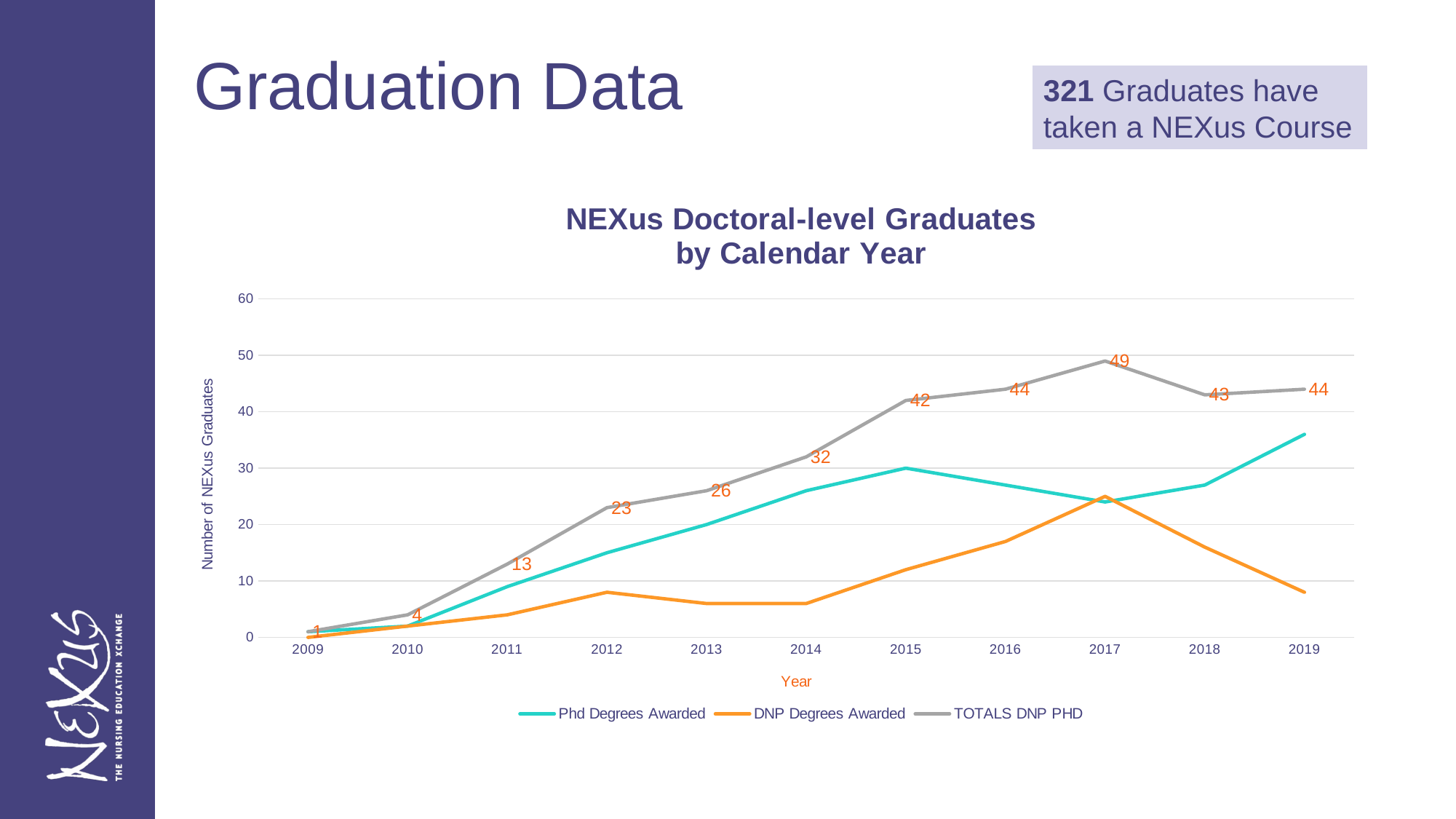
Does the TOTALS DNP PHD series rise or fall from 2009 to 2017? rise What is the TOTALS DNP PHD value for 2017? 49 In which year is the TOTALS DNP PHD value highest? 2017 In which year is the TOTALS DNP PHD value lowest? 2009 What type of chart is shown on the slide? line chart Is the value for DNP Degrees Awarded in 2019 greater or less than 10? less What is the difference between the TOTALS DNP PHD values for 2017 and 2018? 6 How many years are plotted along the x axis? 11 Which year has a larger TOTALS DNP PHD value, 2014 or 2015? 2015 How many series does the legend list? 3 What is the TOTALS DNP PHD value for 2012? 23 Is the value for Phd Degrees Awarded in 2019 greater or less than 30? greater